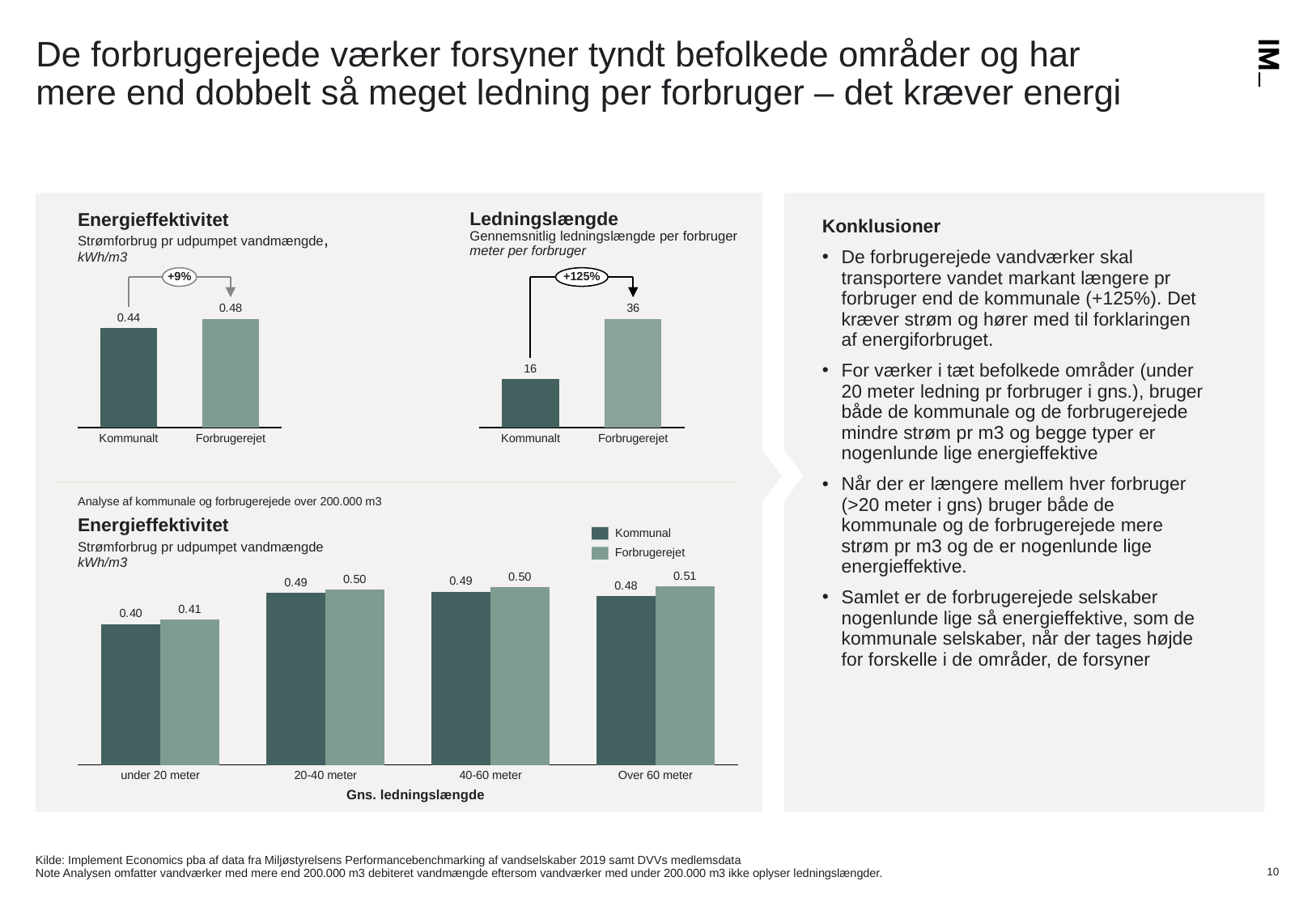
In the Ledningslængde chart, what is the difference between Forbrugerejet and Kommunalt? 20 In the bottom Energieffektivitet chart, how many categories are shown on the x axis? 4 In the bottom Energieffektivitet chart, which category has the lowest Kommunal value? under 20 meter In the Ledningslængde chart, which category has the higher value? Forbrugerejet In the Ledningslængde chart, what percentage change is shown between Kommunalt and Forbrugerejet? +125% In the top-left Energieffektivitet chart, what is the value for Forbrugerejet? 0.48 In the bottom Energieffektivitet chart, what is the Kommunal value for under 20 meter? 0.40 In the Ledningslængde chart, what is the value for Forbrugerejet? 36 In the top-left Energieffektivitet chart, what is the value for Kommunalt? 0.44 In the bottom Energieffektivitet chart, how many series does the legend list? 2 What type of chart is the Ledningslængde chart? Bar chart In the bottom Energieffektivitet chart, what is the Forbrugerejet value for Over 60 meter? 0.51